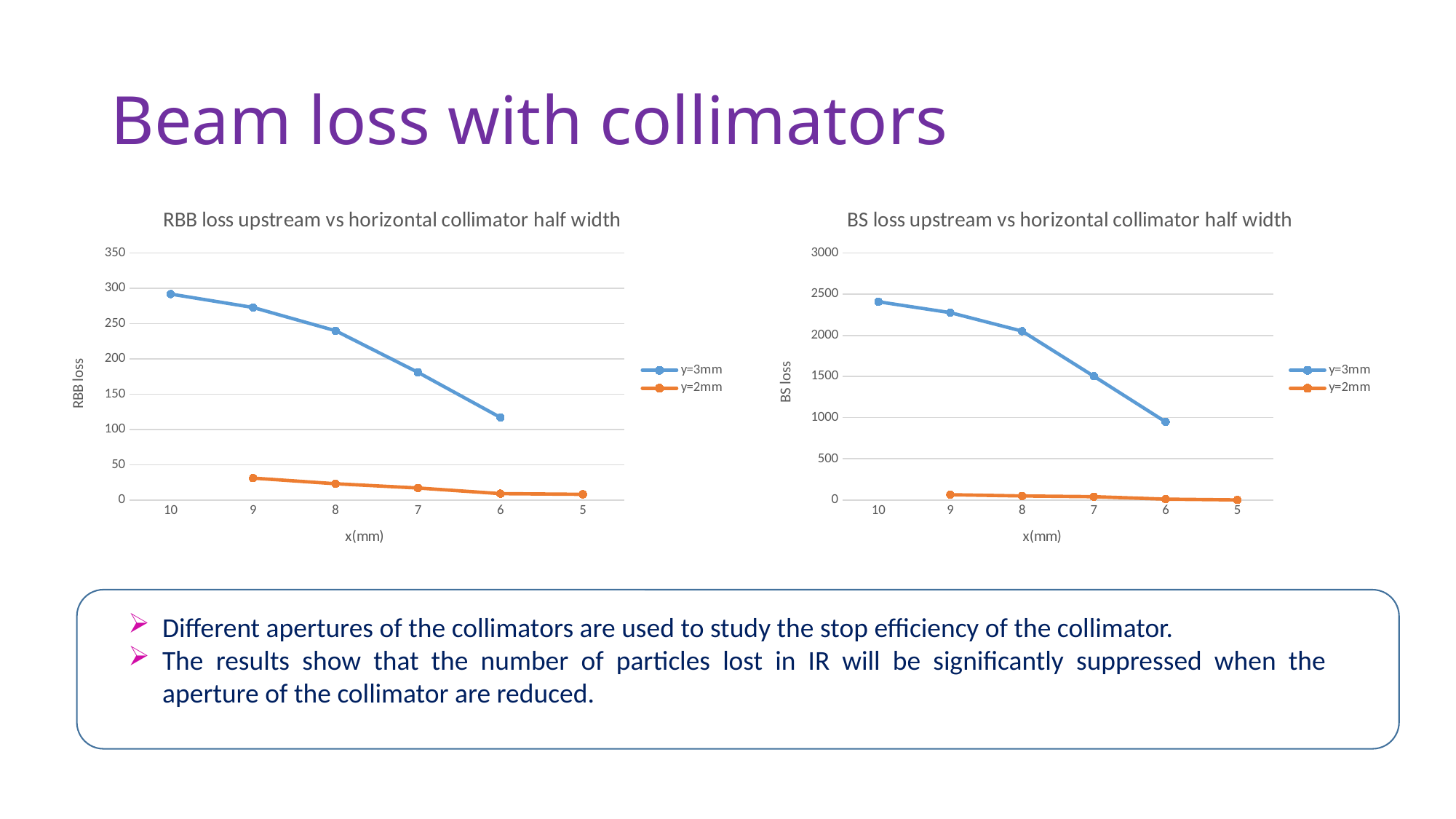
What is the x-axis label on the 'BS loss upstream vs horizontal collimator half width' chart? x(mm) How many series does the legend of the 'BS loss upstream vs horizontal collimator half width' chart list? 2 How many x-axis categories are shown on the 'RBB loss upstream vs horizontal collimator half width' chart? 6 What kind of chart is the 'RBB loss upstream vs horizontal collimator half width' chart? line chart In the 'BS loss upstream vs horizontal collimator half width' chart, is the y=3mm value at x=10 greater or less than 2000? greater What are the two legend entries on the 'RBB loss upstream vs horizontal collimator half width' chart? y=3mm and y=2mm In the 'RBB loss upstream vs horizontal collimator half width' chart, which series has the higher value at x=8, y=3mm or y=2mm? y=3mm In the 'RBB loss upstream vs horizontal collimator half width' chart, is the y=3mm value at x=10 greater or less than 250? greater In the 'BS loss upstream vs horizontal collimator half width' chart, at which x value is the y=3mm series highest? 10 In the 'BS loss upstream vs horizontal collimator half width' chart, is the y=3mm value at x=6 greater or less than 1500? less In the 'RBB loss upstream vs horizontal collimator half width' chart, do the y=3mm values rise or fall moving left to right along the x axis? fall